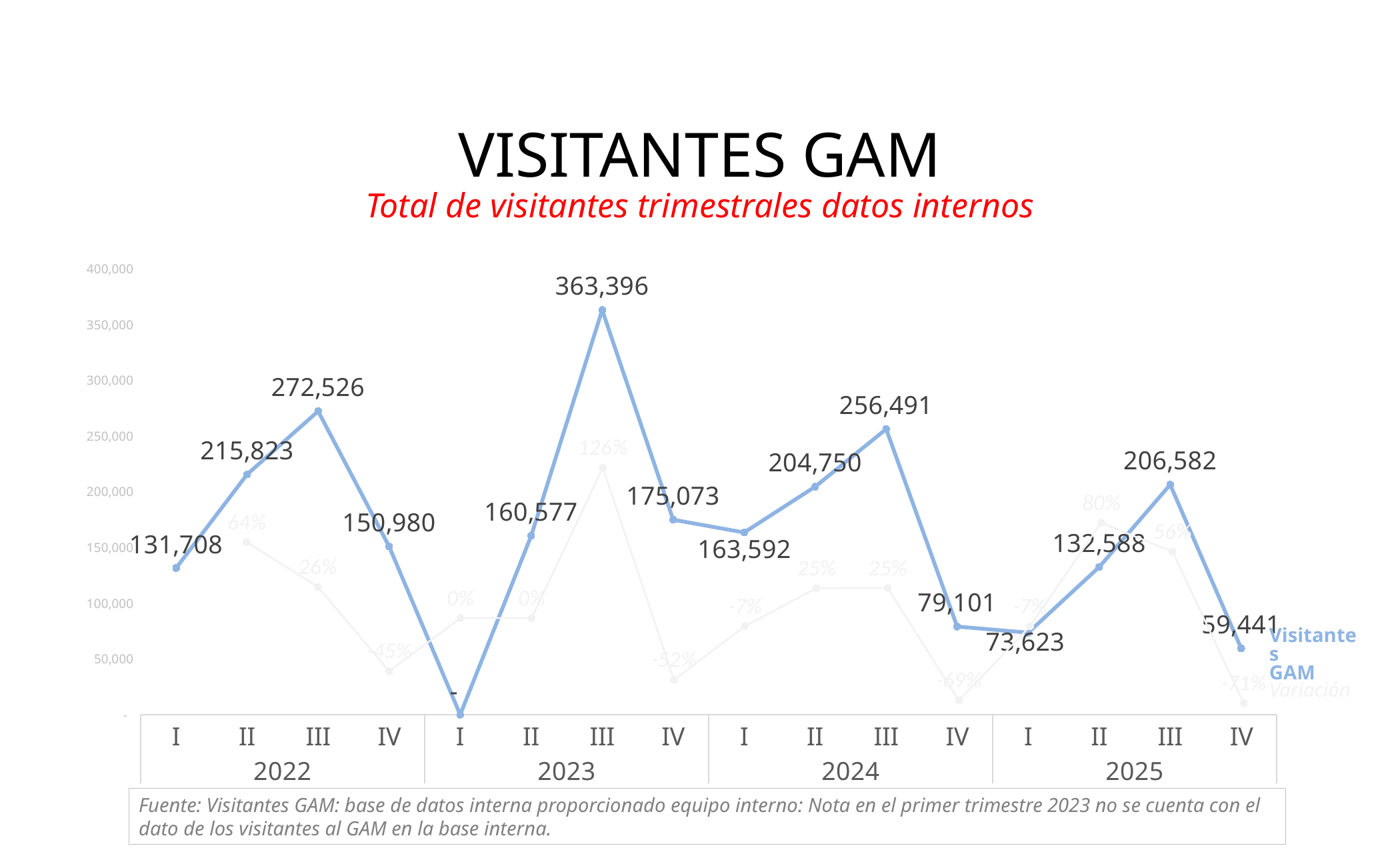
What is the value for quarter IV of 2025? 59,441 What is the value for quarter I of 2022? 131,708 What is the value for quarter III of 2023? 363,396 Which quarter has the highest number of visitors? III 2023 What is the difference between quarter III of 2022 and quarter IV of 2022? 121,546 What is the subtitle shown in red below the chart title? Total de visitantes trimestrales datos internos What kind of chart is shown on the slide? Line chart Which is larger, the value for quarter II of 2024 or quarter III of 2025? Quarter III of 2025 Which quarter with a printed value has the lowest number of visitors? IV 2025 Is the value for quarter IV of 2024 greater or less than 100,000? less What is the value for quarter III of 2024? 256,491